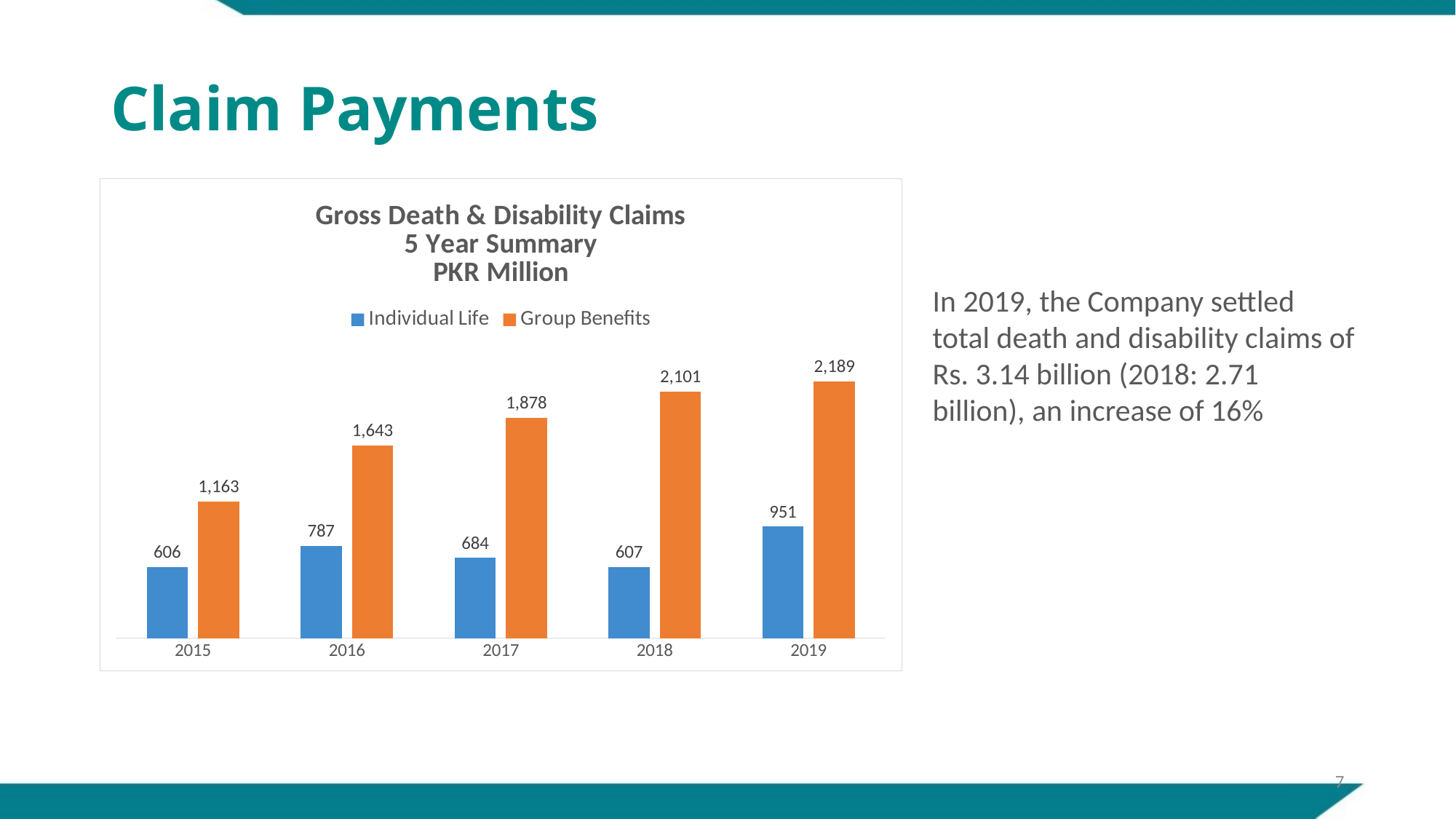
What unit is stated in the chart title? PKR Million Which is larger, the Individual Life value for 2016 or for 2017? 2016 What is the Group Benefits value for 2017? 1,878 What is the Group Benefits value for 2019? 2,189 What kind of chart is shown? Bar chart Do the Group Benefits values rise or fall from 2015 to 2019? Rise How many series does the legend list? 2 How many years are shown on the x axis? 5 What is the difference between the Group Benefits and Individual Life values in 2018? 1,494 Which year has the lowest Group Benefits value? 2015 What is the Individual Life value for 2015? 606 Which year has the highest Individual Life value? 2019